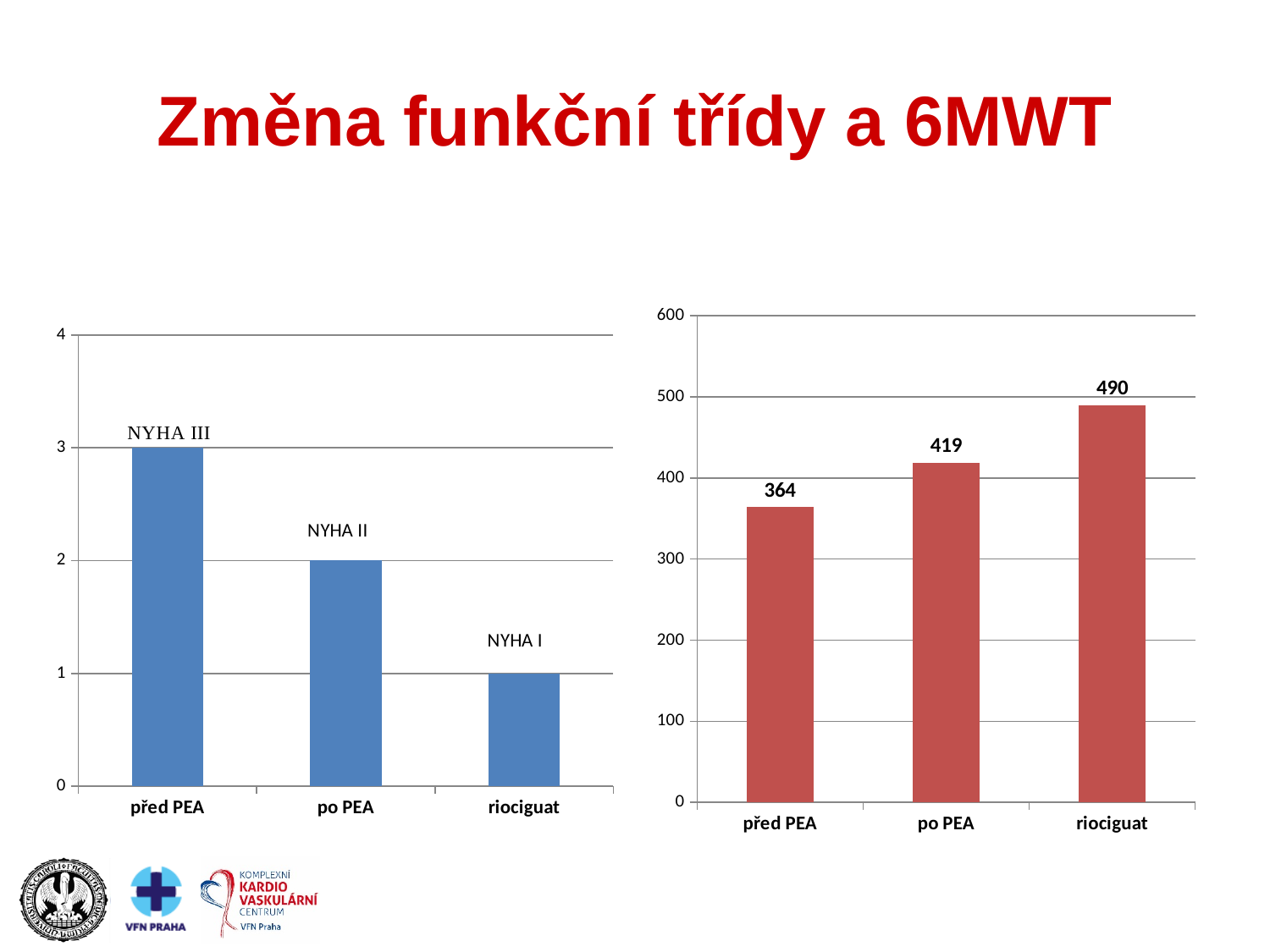
In the left-hand chart, what value does the bar for před PEA reach? 3 In the right-hand chart, do the values rise or fall from před PEA to riociguat? rise In the right-hand chart, is the value for po PEA greater or less than 400? greater How many categories are shown in the left-hand chart? 3 What type of chart is the right-hand chart? bar chart In the right-hand chart, which category has the lowest value? před PEA In the right-hand chart, which category has the highest value? riociguat In the left-hand chart, what label is shown above the bar for po PEA? NYHA II In the right-hand chart, what is the difference between the values for riociguat and před PEA? 126 In the left-hand chart, which category has the lowest bar? riociguat In the right-hand chart, what is the value for po PEA? 419 In the right-hand chart, what is the value for riociguat? 490